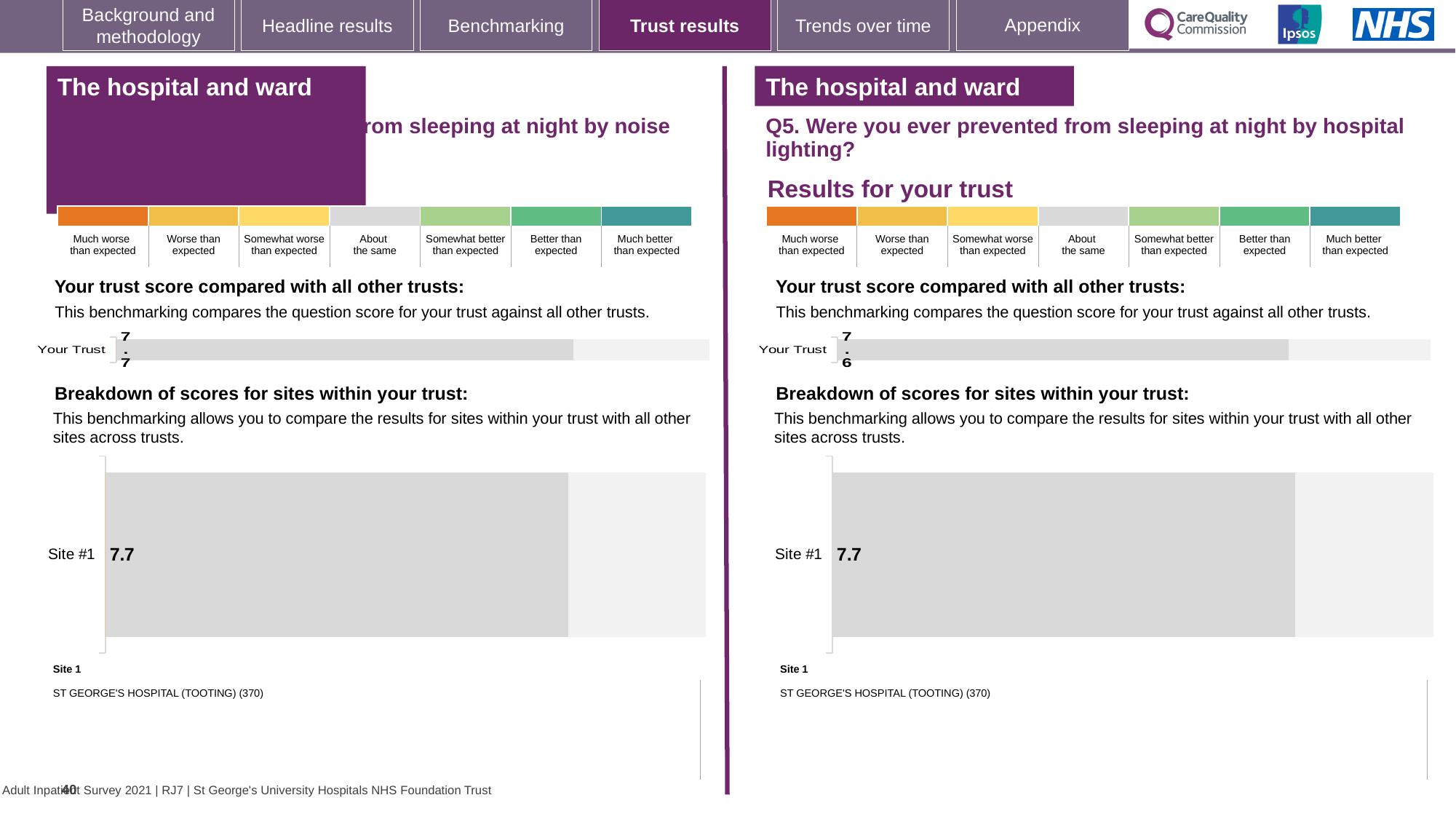
How many sites are shown in the breakdown of scores chart on the right-hand side of the slide? 1 On the right-hand side of the slide (Q5, hospital lighting), what is the difference between the Site #1 score and the Your Trust score? 0.1 What is the question number shown on the right-hand side of the slide about hospital lighting? Q5 On the right-hand side of the slide (Q5, hospital lighting), which is larger: the Your Trust score or the Site #1 score? Site #1 On the right-hand side of the slide (Q5, hospital lighting), what is the score shown for Site #1? 7.7 How many sites are shown in the breakdown of scores chart on the left-hand side of the slide? 1 On the left-hand side of the slide (sleeping at night by noise), what is the score shown for Site #1? 7.7 On the right-hand side of the slide (Q5, hospital lighting), what is the score shown for Your Trust? 7.6 On the left-hand side of the slide (sleeping at night by noise), what is the score shown for Your Trust? 7.7 What type of chart is used to show the Site #1 score on the right-hand side of the slide? Bar chart Which site is listed as Site 1 on the right-hand side of the slide? ST GEORGE'S HOSPITAL (TOOTING) (370)